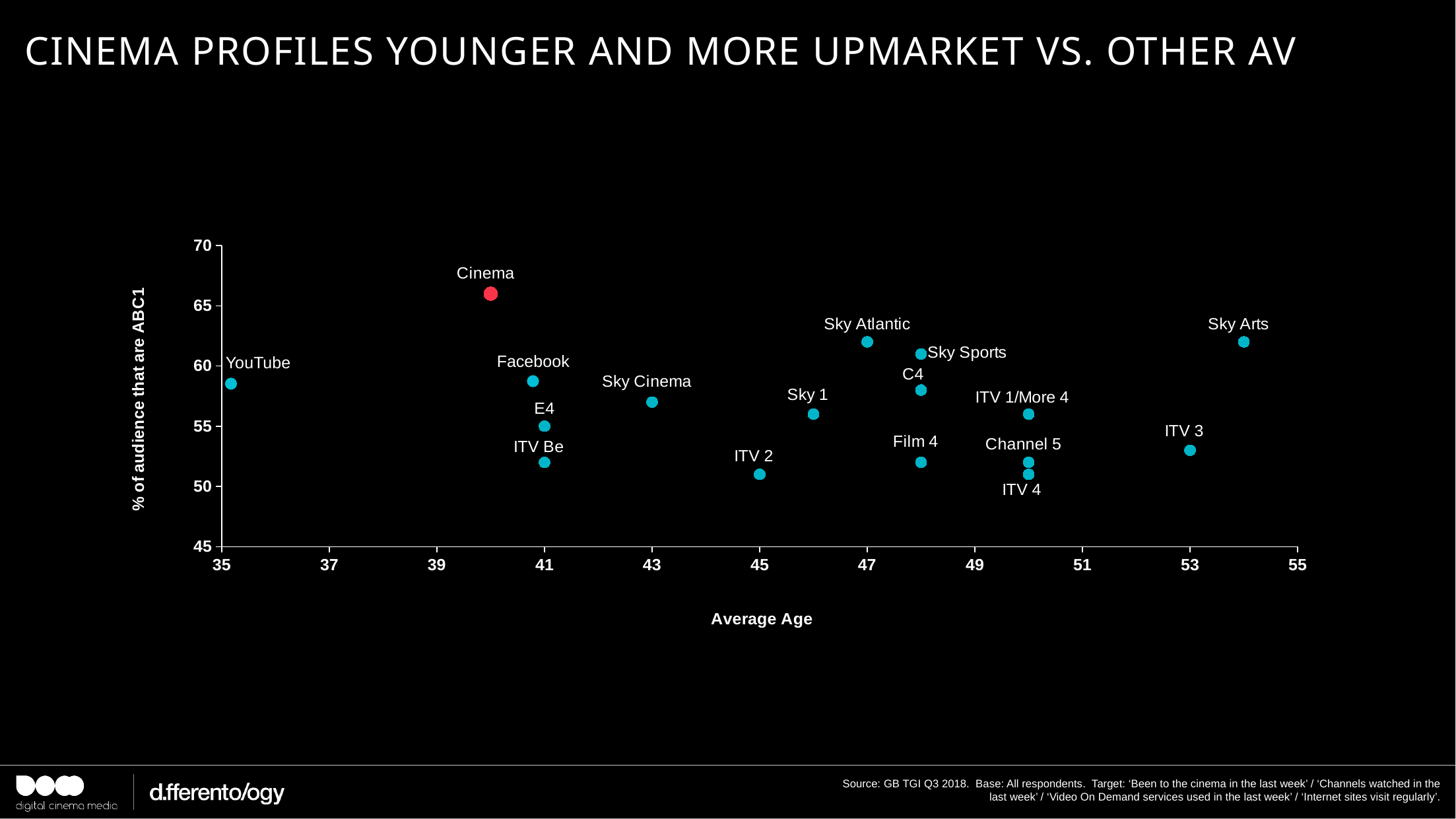
How many points are plotted on the chart? 17 Which has a higher % of audience that are ABC1, Facebook or E4? Facebook Which point has the highest average age? Sky Arts Is the % of audience that are ABC1 for ITV 3 greater or less than 55? less Which has a higher average age, Sky Arts or ITV 3? Sky Arts Which point on the chart is highlighted in red rather than blue? Cinema Is the % of audience that are ABC1 for Cinema greater or less than 65? greater Is the average age for YouTube greater or less than 37? less Which point has the highest % of audience that are ABC1? Cinema What kind of chart is shown on the slide? Scatter chart Which point has the lowest average age? YouTube